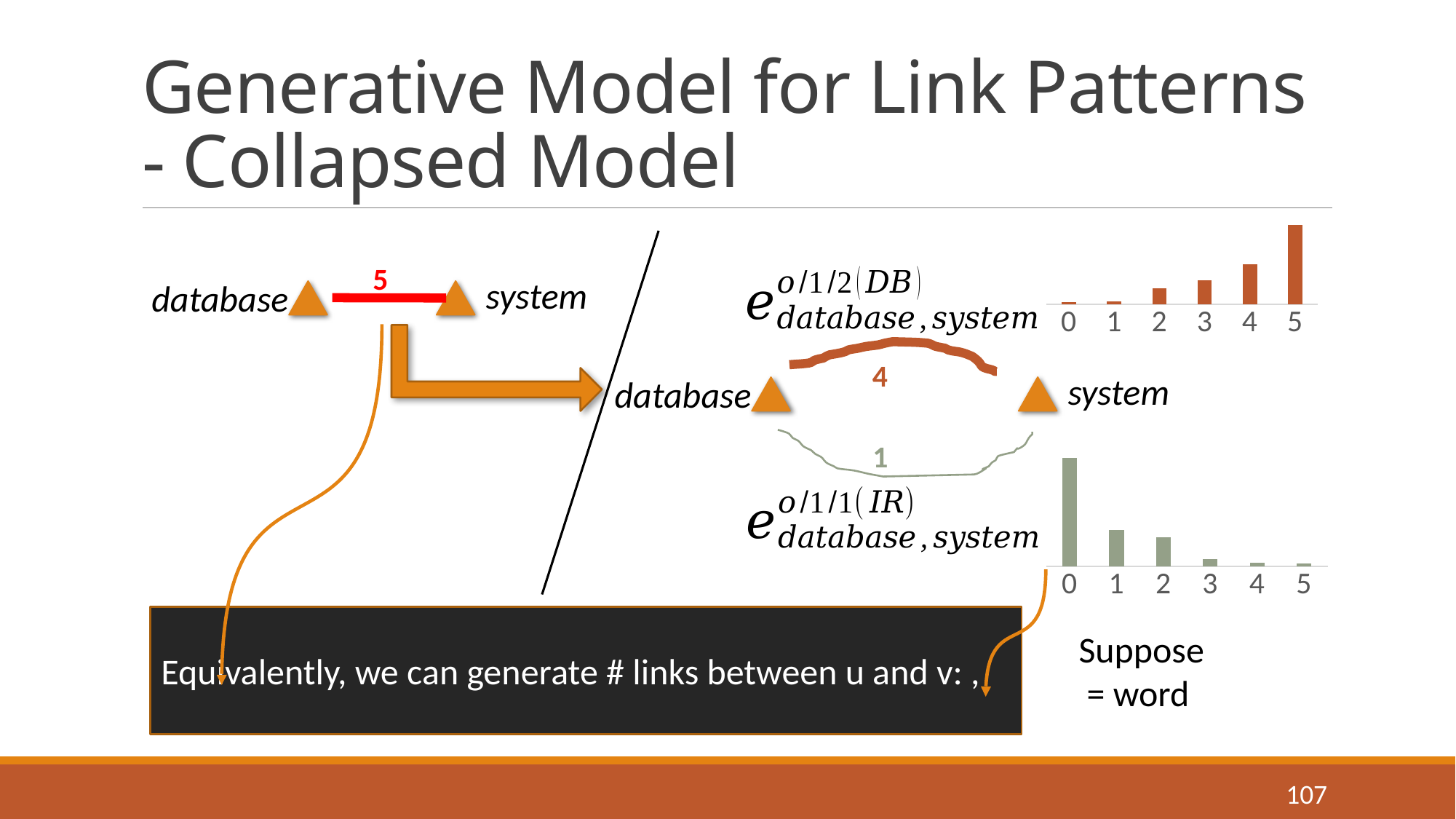
In the upper right bar chart, which is taller, the bar for 3 or the bar for 5? 5 In the upper right bar chart, which category has the tallest bar? 5 In the upper right bar chart, do the bars rise or fall as the x axis goes from 0 to 5? rise How many categories are shown on the x axis of the upper right bar chart? 6 What colour are the bars in the upper right bar chart? orange-brown In the lower right bar chart, which is taller, the bar for 0 or the bar for 2? 0 What kind of chart is the lower chart on the right side of the slide? bar chart How many categories are shown on the x axis of the lower right bar chart? 6 In the lower right bar chart, do the bars rise or fall as the x axis goes from 0 to 5? fall What colour are the bars in the lower right bar chart? grey-green In the lower right bar chart, which category has the tallest bar? 0 What kind of chart is the upper chart on the right side of the slide? bar chart